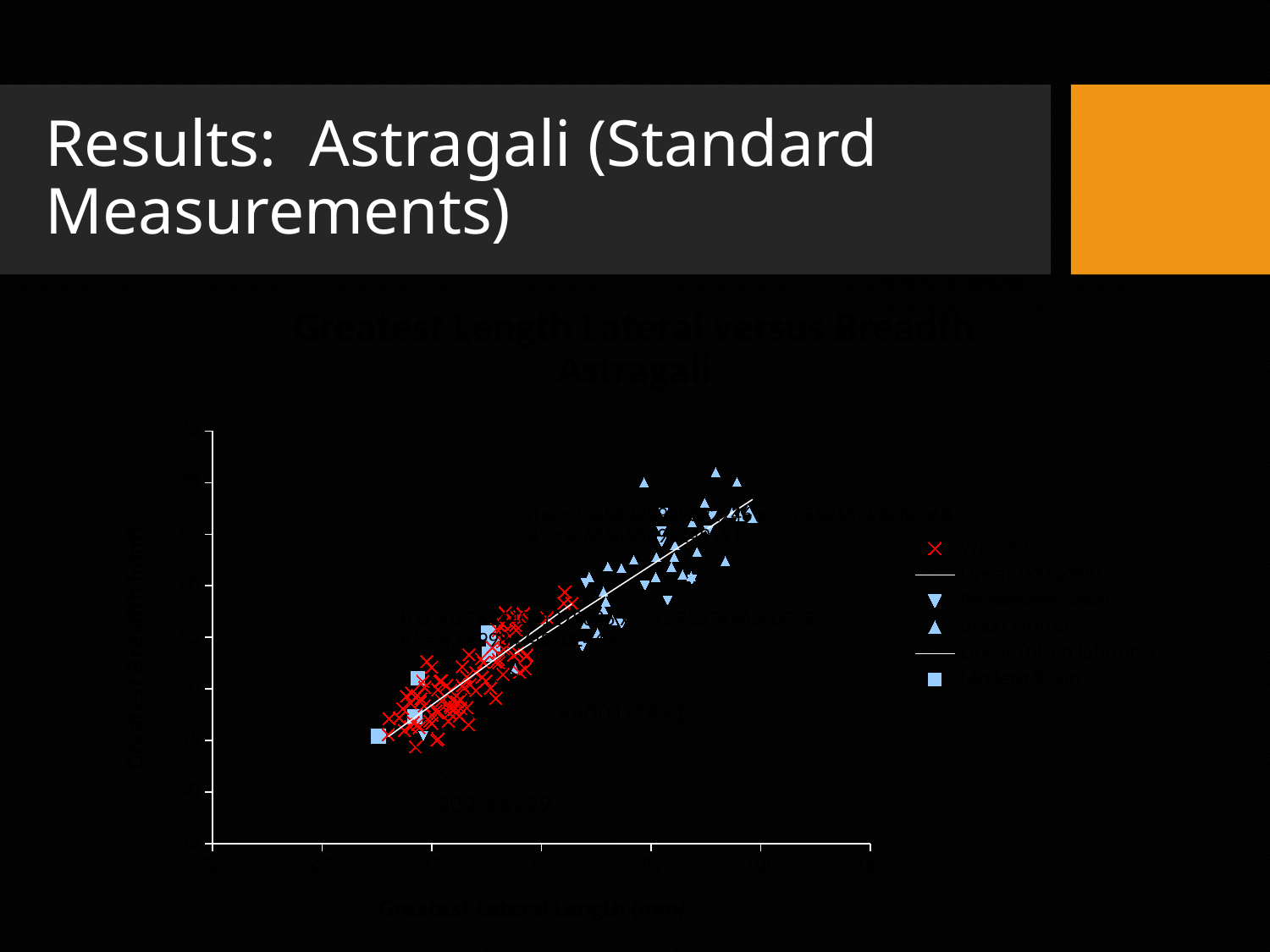
What is the label on the y axis of the chart? Greatest Breadth (mm) How many entries does the chart legend list? 6 What is the label on the x axis of the chart? Greatest Lateral Length (mm) Is the highest plotted breadth value on the chart greater or less than 75? less Do the plotted breadth values generally rise or fall as greatest lateral length increases along the x axis? rise What kind of chart is shown on the slide? scatter chart Is the lowest plotted breadth value greater or less than 40? greater Is the smallest plotted greatest lateral length value greater or less than 65? greater